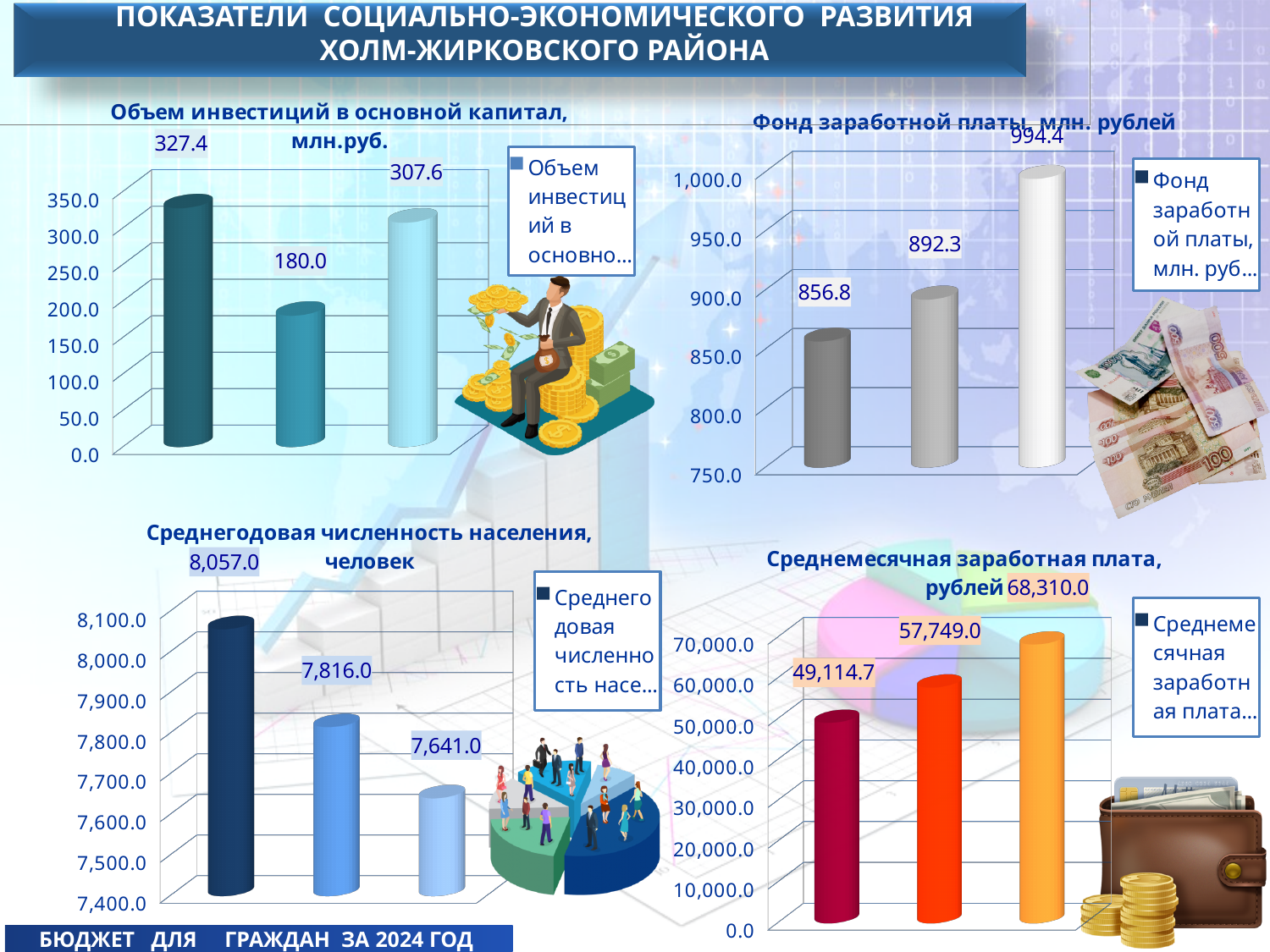
On the chart 'Объем инвестиций в основной капитал, млн.руб.', what is the difference between the first bar and the third bar? 19.8 On the chart 'Среднемесячная заработная плата, рублей', is the first bar larger or smaller than the second bar? smaller On the chart 'Фонд заработной платы, млн. рублей', do the values rise or fall from left to right? rise On the chart 'Среднемесячная заработная плата, рублей', which bar has the highest value? the third (rightmost) bar, 68,310.0 What type of chart is 'Среднемесячная заработная плата, рублей'? bar chart On the chart 'Среднегодовая численность населения, человек', what is the difference between the first bar and the third bar? 416.0 On the chart 'Среднегодовая численность населения, человек', do the values rise or fall from left to right? fall On the chart 'Объем инвестиций в основной капитал, млн.руб.', which bar has the lowest value? the second (middle) bar, 180.0 On the chart 'Объем инвестиций в основной капитал, млн.руб.', what is the value of the first (leftmost) bar? 327.4 On the chart 'Среднегодовая численность населения, человек', what is the value of the second (middle) bar? 7,816.0 On the chart 'Фонд заработной платы, млн. рублей', how many bars are plotted? 3 On the chart 'Фонд заработной платы, млн. рублей', what is the value of the third (rightmost) bar? 994.4